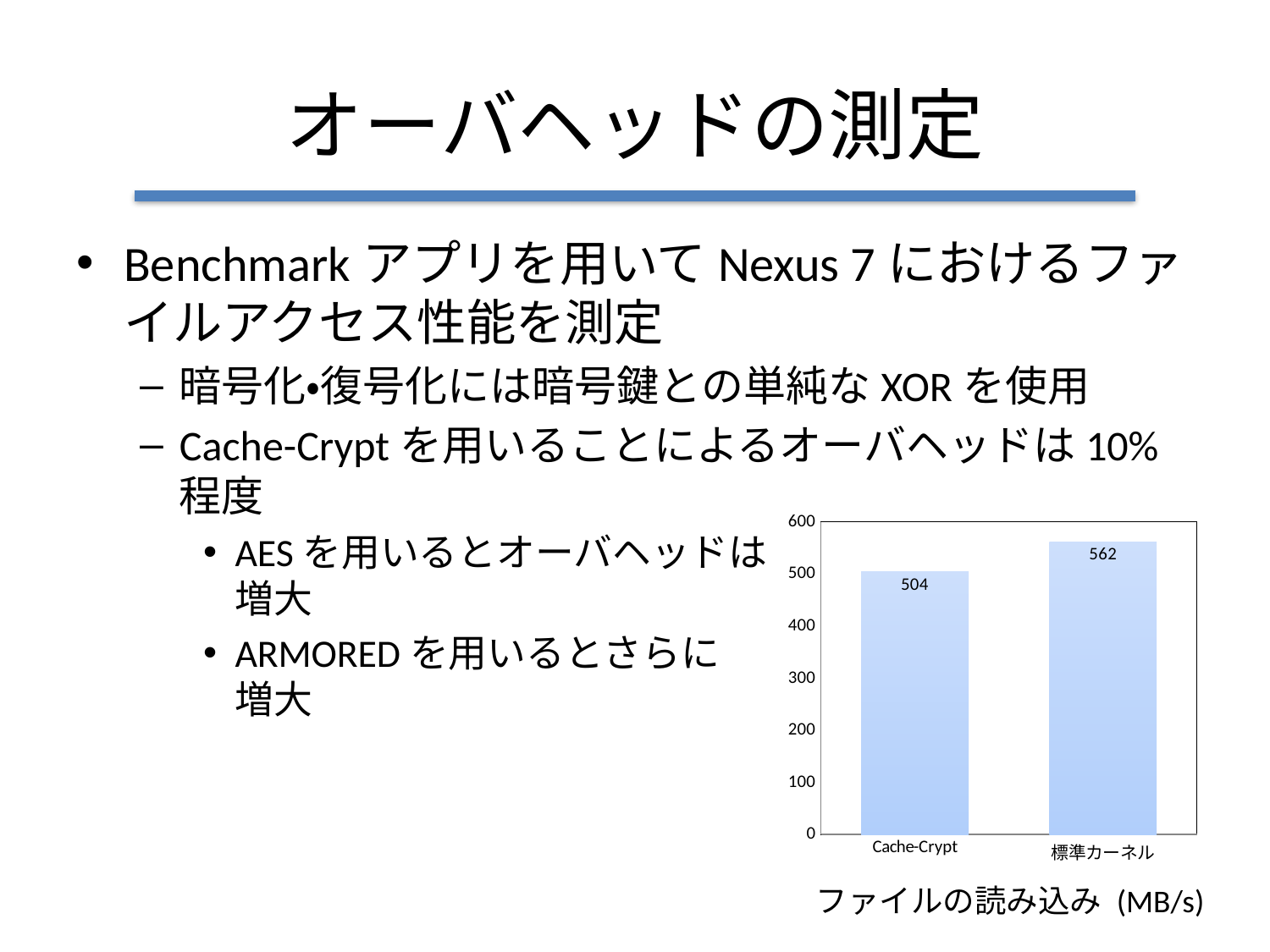
Which is larger, the value for Cache-Crypt or the value for 標準カーネル? 標準カーネル How many categories are shown in the chart? 2 What is the caption below the chart? ファイルの読み込み (MB/s) What is the value for 標準カーネル in the chart? 562 What kind of chart is shown on the slide? bar chart Which category has the highest value in the chart? 標準カーネル What is the maximum value shown on the y axis of the chart? 600 Which category has the lowest value in the chart? Cache-Crypt Is the value for 標準カーネル greater or less than 600? less Is the value for Cache-Crypt greater or less than 400? greater What is the difference between the values for 標準カーネル and Cache-Crypt? 58 What is the value for Cache-Crypt in the chart? 504